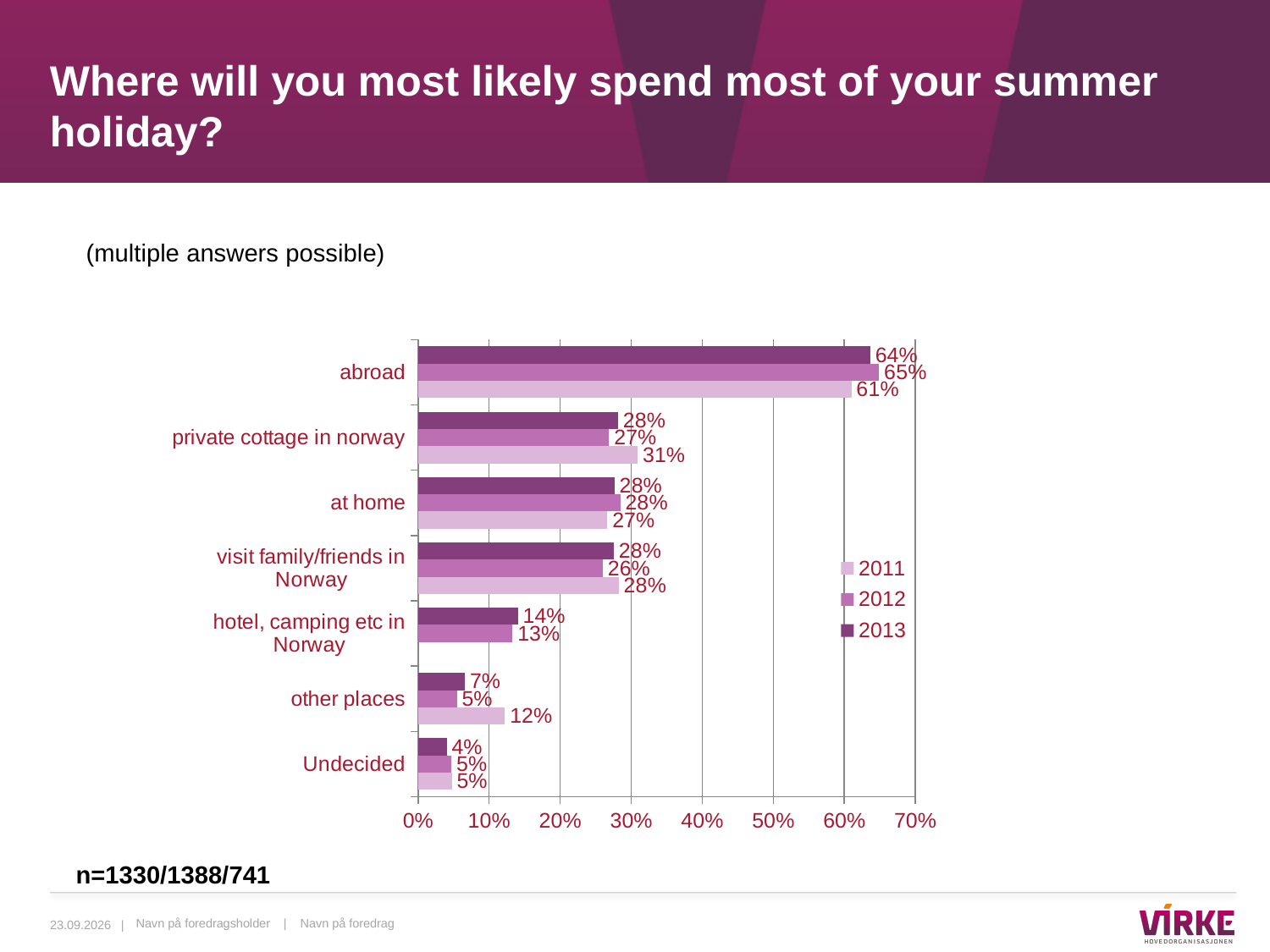
What is the value for other places in 2013? 7% What is the difference between the 2012 and 2011 values for abroad? 4% What kind of chart is shown on the slide? bar chart How many categories are shown on the chart? 7 What is the total of the three values shown for Undecided? 14% What is the value for private cottage in norway in 2011? 31% Which category has the lowest value in 2013? Undecided Which category has the highest value in 2013? abroad What is the value for abroad in 2012? 65% What is the value for hotel, camping etc in Norway in 2012? 13% Which is larger for other places: the 2011 value or the 2013 value? 2011 How many series does the legend list? 3